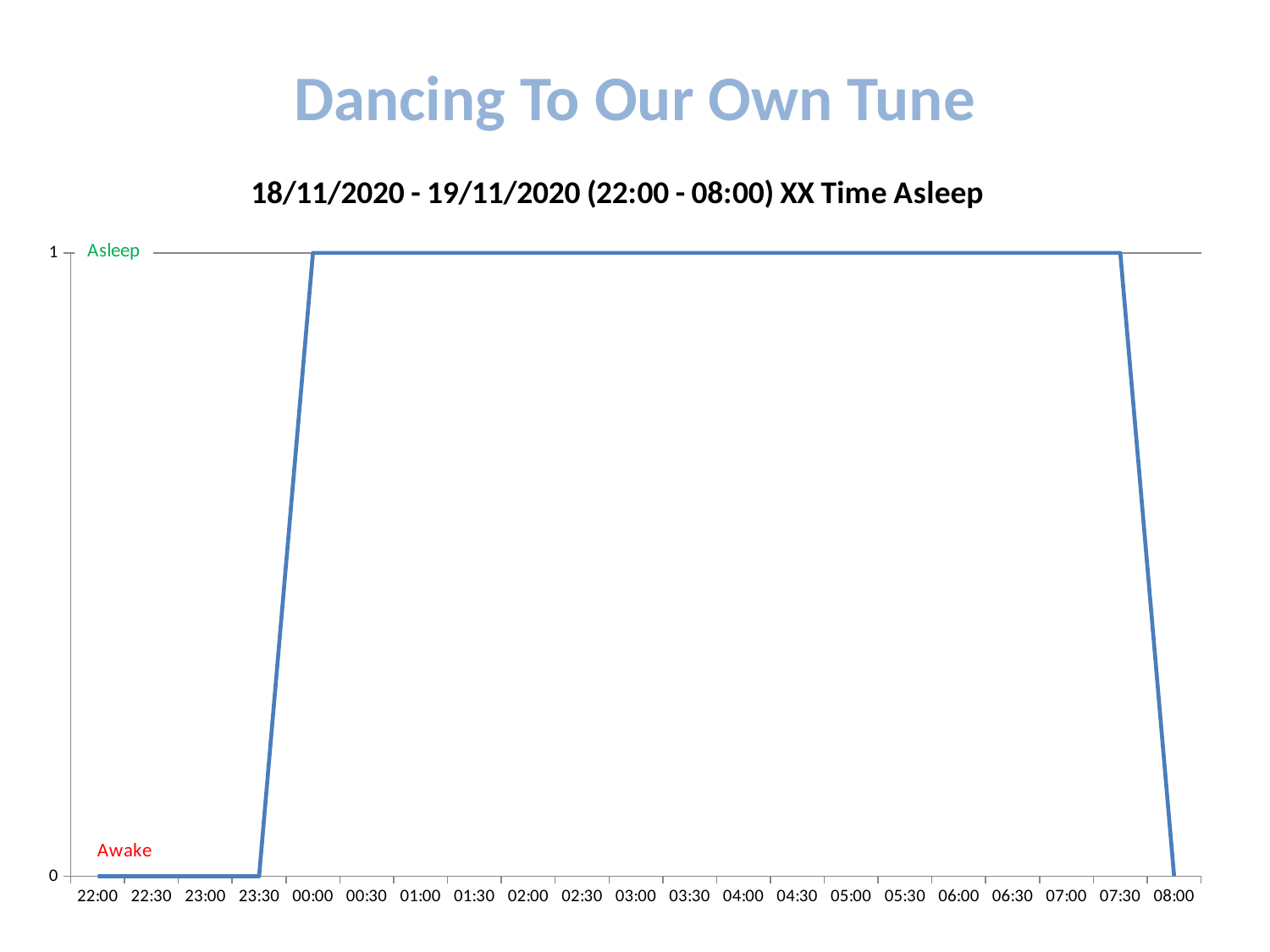
What is the value at 22:00? 0 What is the title of the chart? 18/11/2020 - 19/11/2020 (22:00 - 08:00) XX Time Asleep What label is shown next to the y-axis value 0? Awake What is the value at 00:00? 1 What is the value at 08:00? 0 What is the value at 23:30? 0 Which is larger, the value at 23:00 or the value at 03:00? 03:00 Does the line rise or fall between 23:30 and 00:00? rise What is the value at 07:30? 1 How many time points are labelled on the x axis? 21 What is the difference between the value at 04:00 and the value at 22:30? 1 What kind of chart is shown on the slide? line chart